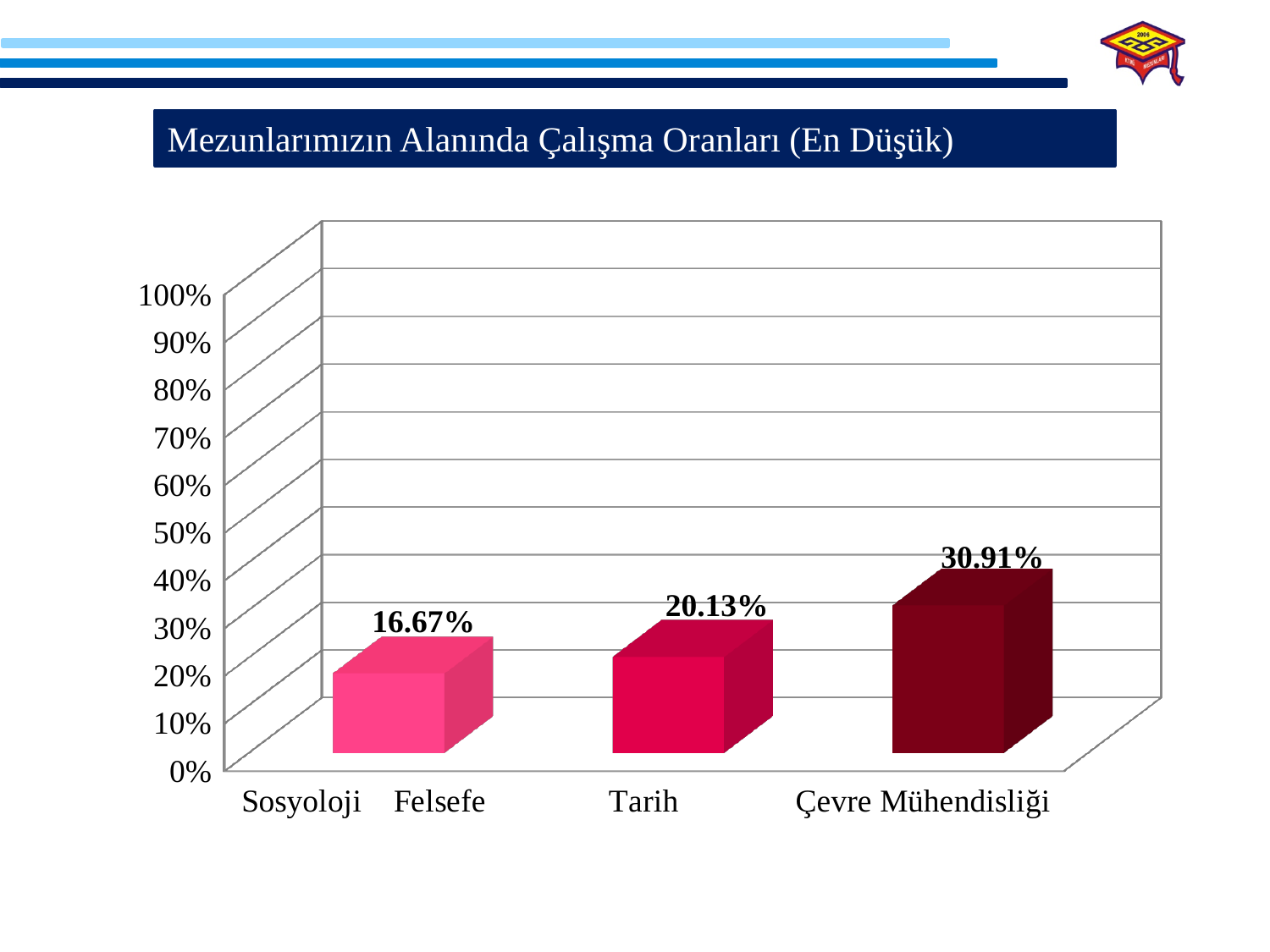
What is the value shown for Tarih? 20.13% What is the title of the chart? Mezunlarımızın Alanında Çalışma Oranları (En Düşük) What is the difference between the values for Çevre Mühendisliği and Tarih? 10.78% Which bar has the lowest value? Sosyoloji Felsefe How many bars are plotted in the chart? 3 Which is larger, the value for Tarih or the value for Çevre Mühendisliği? Çevre Mühendisliği What is the difference between the values for Tarih and the leftmost bar (Sosyoloji Felsefe)? 3.46% What is the value shown for Çevre Mühendisliği? 30.91% What is the value shown on the leftmost bar (Sosyoloji Felsefe)? 16.67% What kind of chart is shown on the slide? Bar chart Which category has the highest value? Çevre Mühendisliği Is the value for Çevre Mühendisliği greater or less than 50%? less